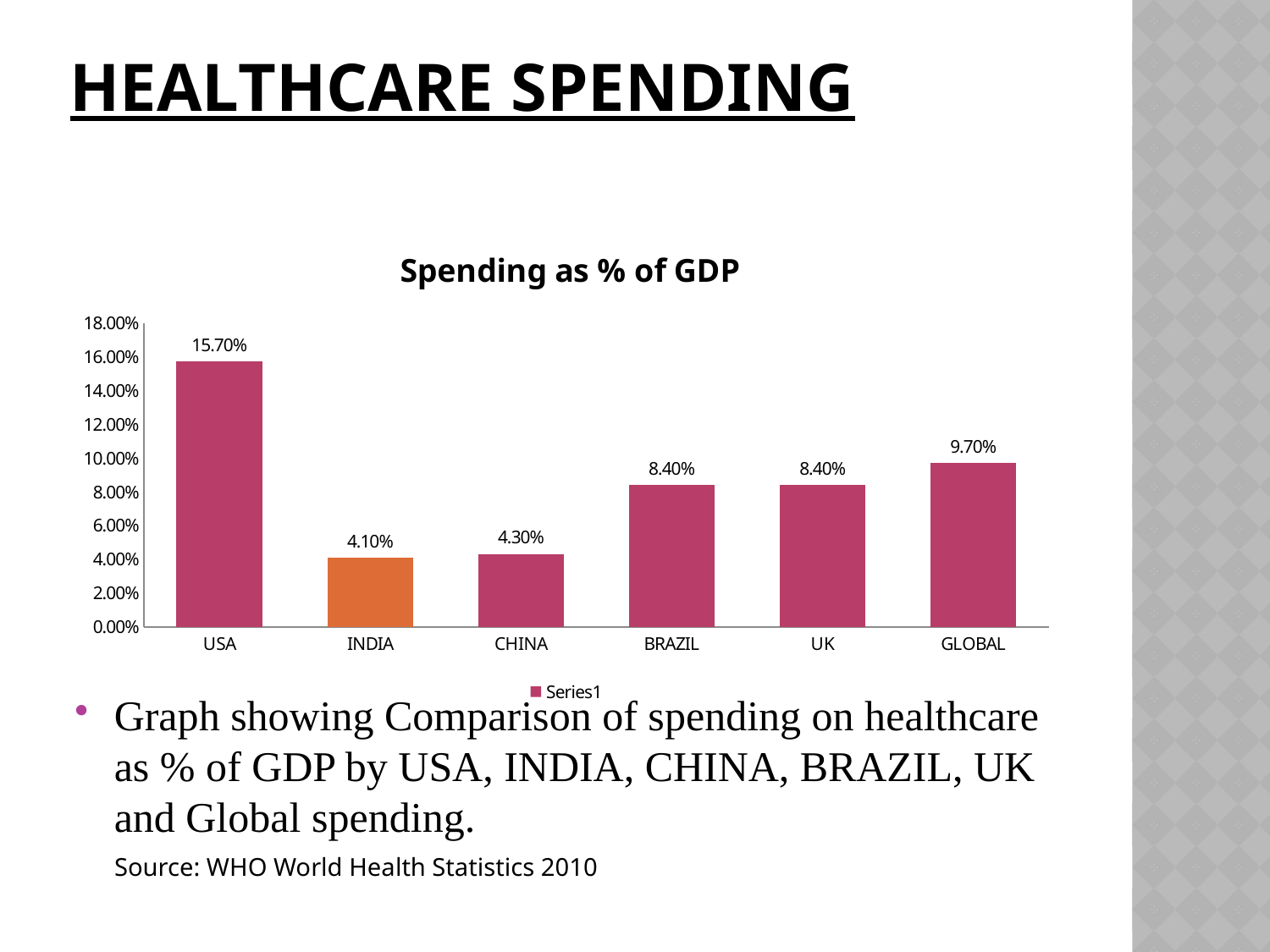
What is the difference between the values for CHINA and INDIA? 0.20% How many categories are shown in the chart? 6 What is the difference between the values for USA and GLOBAL? 6.00% Which is larger, the value for GLOBAL or the value for UK? GLOBAL Which category has the lowest spending as % of GDP? INDIA Which category has the highest spending as % of GDP? USA What kind of chart is shown on the slide? bar chart Is the value for BRAZIL greater or less than 10.00%? less What is the title of the chart? Spending as % of GDP What is the value for INDIA in the chart? 4.10% What is the value for GLOBAL in the chart? 9.70% What is the value for USA in the chart? 15.70%